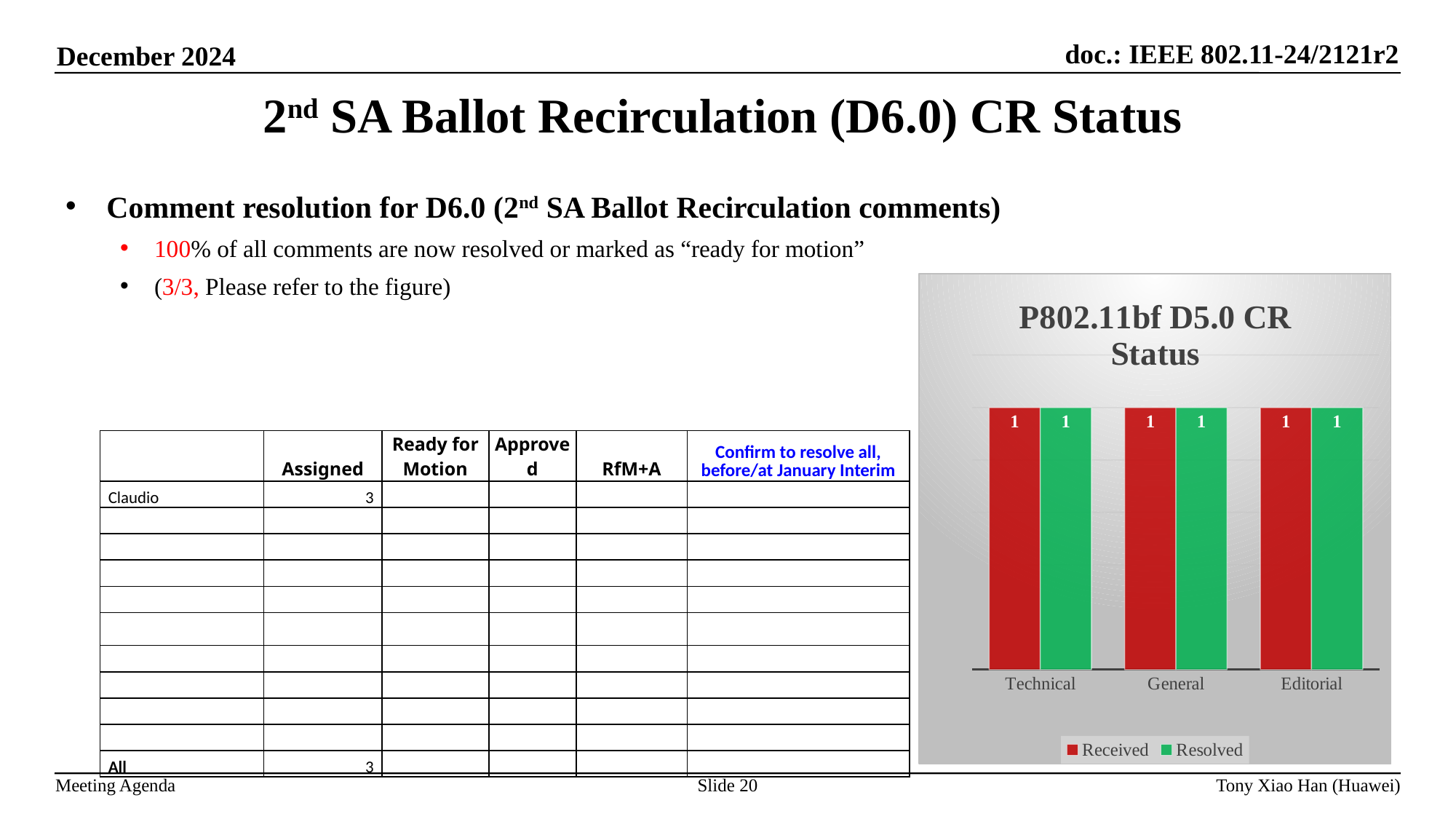
What is the Received value for Editorial in the chart? 1 Do the Received values rise, fall, or stay the same across the categories from Technical to Editorial? stay the same How many categories are shown on the x axis of the chart? 3 What is the Resolved value for General in the chart? 1 What is the Resolved value for Technical in the chart? 1 What is the title of the chart on the slide? P802.11bf D5.0 CR Status What is the Received value for Technical in the chart? 1 How many series does the chart legend list? 2 Which series in the chart is shown in green? Resolved What is the difference between the Received and Resolved values for General in the chart? 0 What is the difference between the Received value for Technical and the Received value for Editorial in the chart? 0 What kind of chart is shown on the slide? bar chart